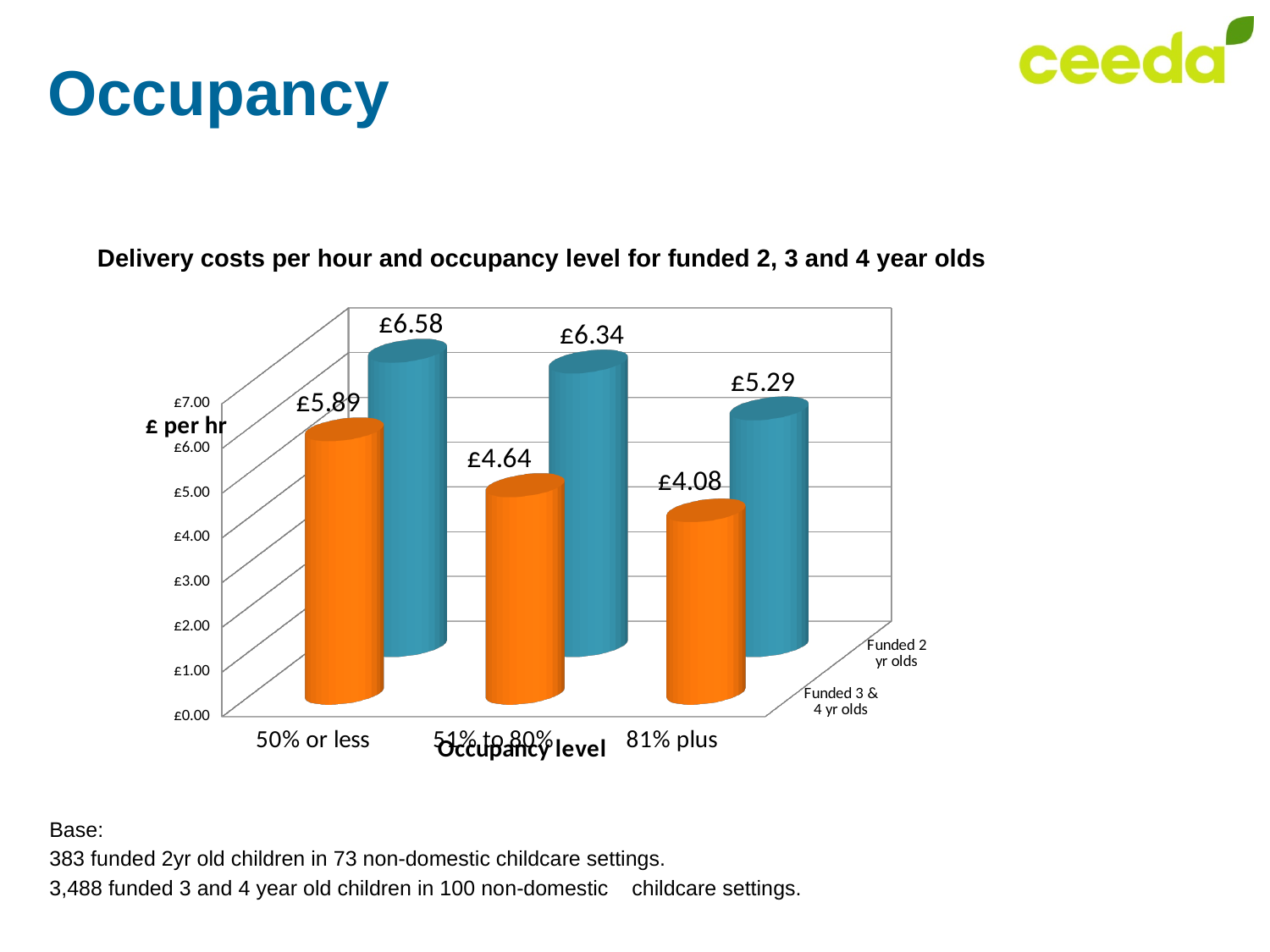
What is the delivery cost per hour for funded 2 yr olds at the 81% plus occupancy level? £5.29 Which occupancy level has the highest delivery cost per hour for funded 3 & 4 yr olds? 50% or less At the 50% or less occupancy level, which group has the higher delivery cost per hour: funded 2 yr olds or funded 3 & 4 yr olds? Funded 2 yr olds How many series does the chart show? 2 Which occupancy level has the lowest delivery cost per hour for funded 2 yr olds? 81% plus How many occupancy levels are shown on the x axis of the chart? 3 What is the delivery cost per hour for funded 2 yr olds at the 50% or less occupancy level? £6.58 What is the delivery cost per hour for funded 3 & 4 yr olds at the 81% plus occupancy level? £4.08 What is the delivery cost per hour for funded 3 & 4 yr olds at the 51% to 80% occupancy level? £4.64 What kind of chart is shown on the slide? Bar chart Do the delivery costs for funded 2 yr olds rise or fall as the occupancy level increases? Fall What is the difference between the funded 2 yr olds and funded 3 & 4 yr olds delivery costs at the 51% to 80% occupancy level? £1.70